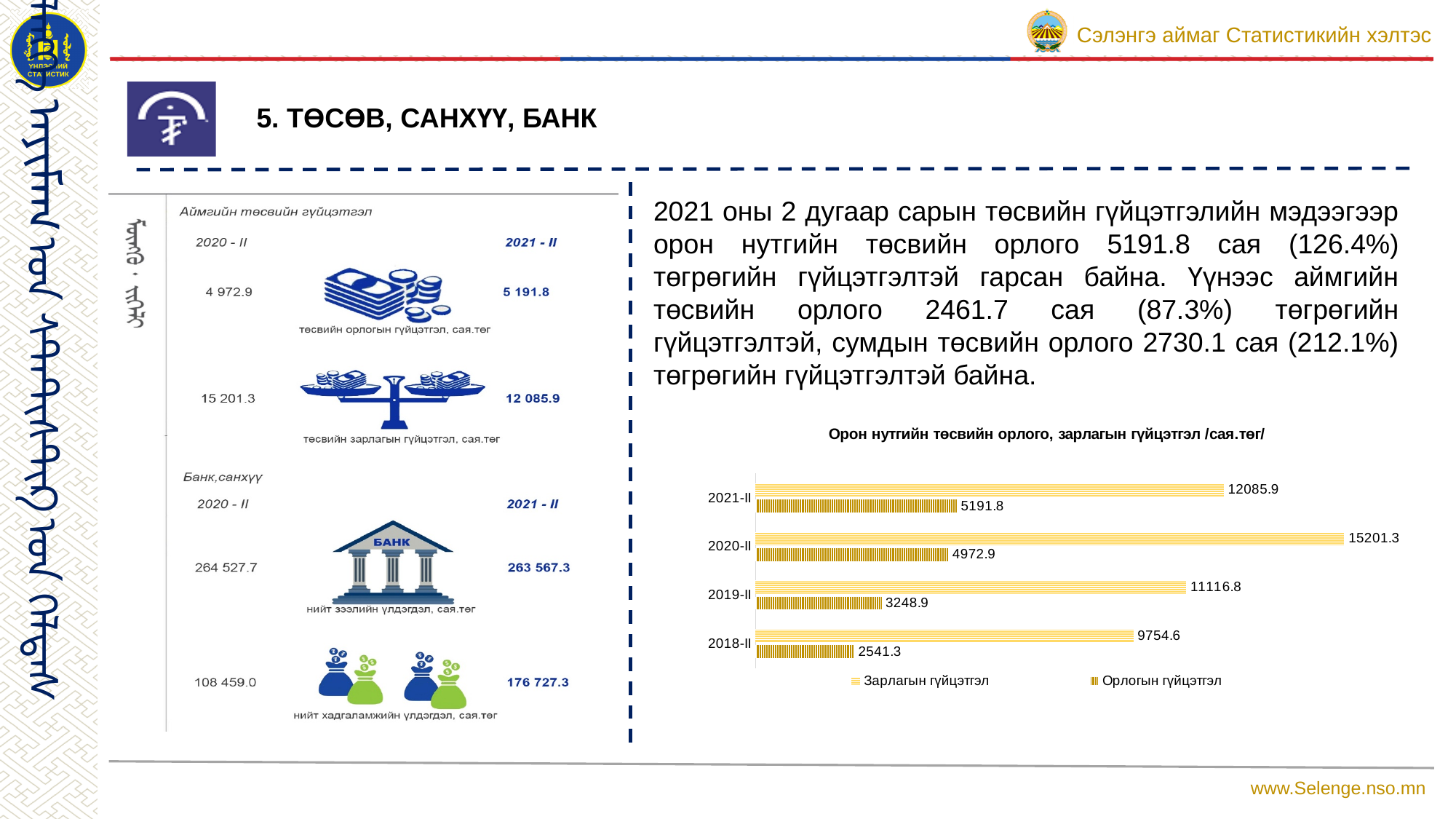
What is the title of the chart? Орон нутгийн төсвийн орлого, зарлагын гүйцэтгэл /сая.төг/ What kind of chart is shown on the slide? Bar chart How many periods are shown on the chart? 4 What is the difference between Зарлагын гүйцэтгэл and Орлогын гүйцэтгэл for 2021-II? 6894.1 Which is larger: Орлогын гүйцэтгэл for 2021-II or for 2020-II? 2021-II What is the value of Орлогын гүйцэтгэл for 2018-II? 2541.3 What is the value of Орлогын гүйцэтгэл for 2020-II? 4972.9 How many series does the legend list? 2 Which period has the highest Зарлагын гүйцэтгэл value? 2020-II Which period has the lowest Орлогын гүйцэтгэл value? 2018-II What is the value of Зарлагын гүйцэтгэл for 2019-II? 11116.8 What is the value of Зарлагын гүйцэтгэл for 2021-II? 12085.9